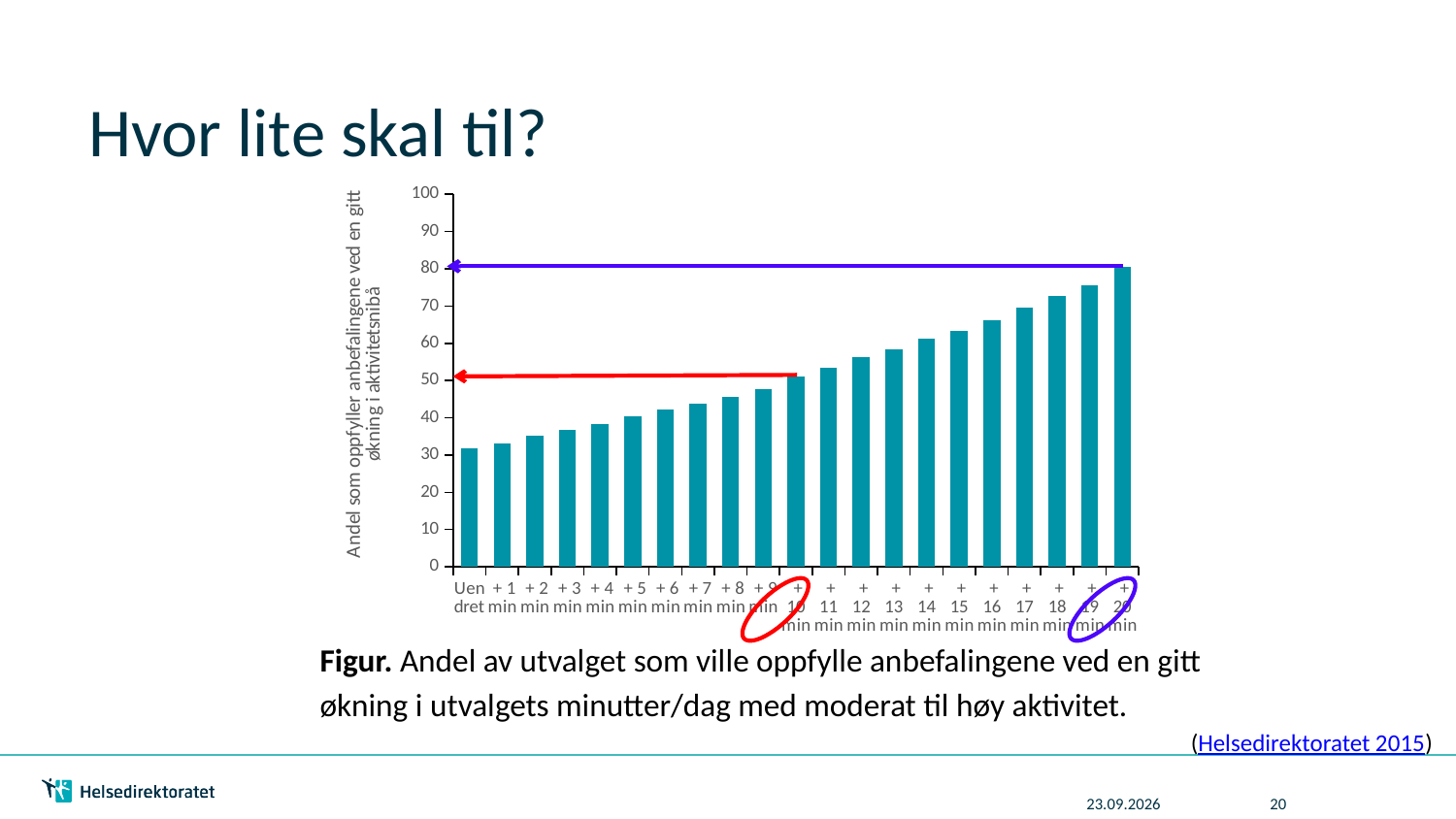
What kind of chart is shown on the slide? bar chart Is the value for + 15 min greater or less than 60? greater Which category has the lowest bar in the chart? Uendret Which category has the highest bar in the chart? + 20 min Is the value for + 5 min greater or less than 50? less How many bars (categories) are plotted in the chart? 21 Do the bar values rise or fall from left to right along the x axis? rise What is the maximum value shown on the y axis of the chart? 100 Which is larger, the value for + 20 min or the value for Uendret? + 20 min Is the value for + 20 min greater or less than 70? greater What is the label on the y axis of the chart? Andel som oppfyller anbefalingene ved en gitt økning i aktivitetsnibå